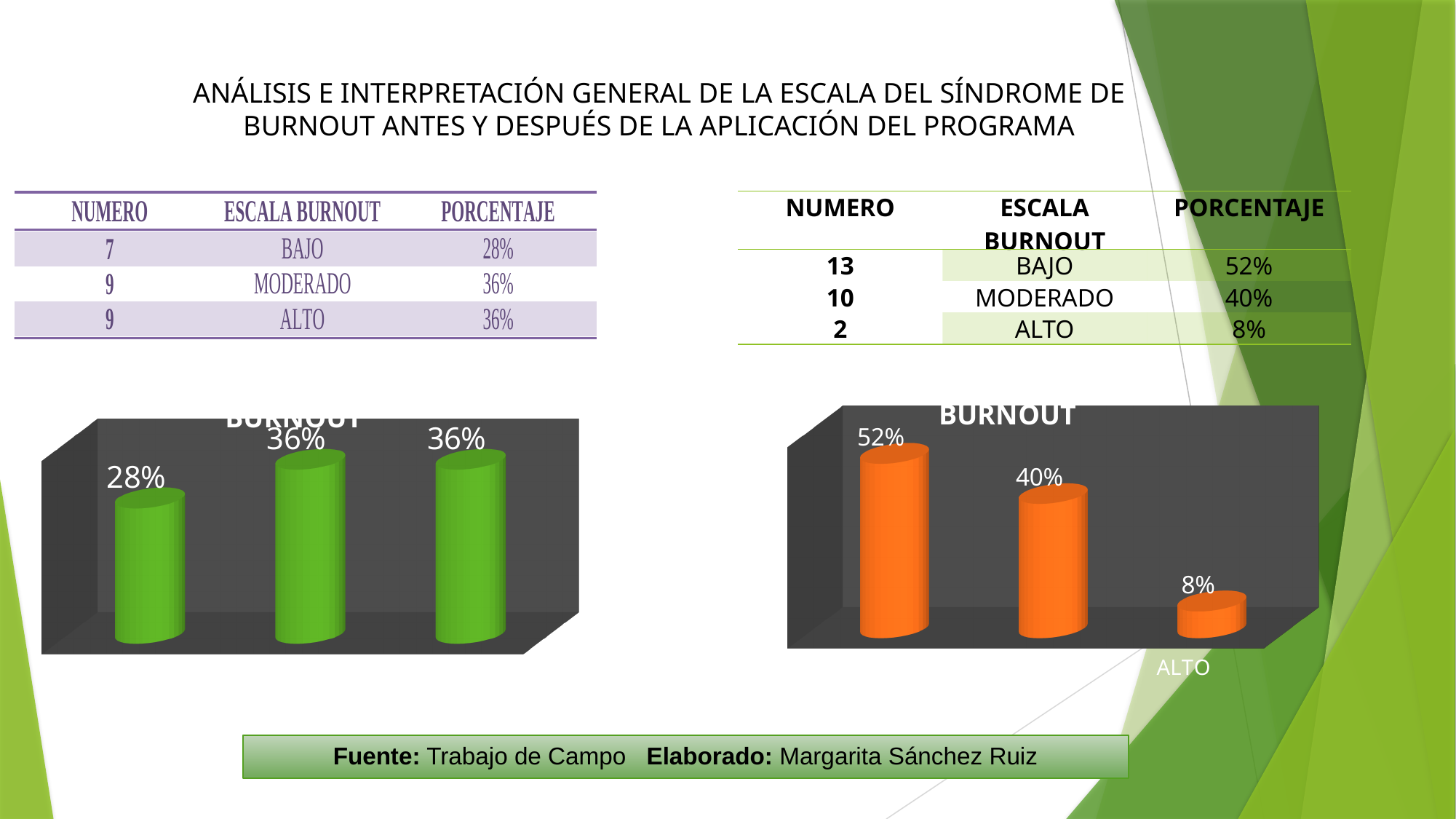
What type of chart is the left chart on the slide? bar chart In the right chart, what is the difference between the first bar (52%) and the second bar (40%)? 12% Do the values in the right chart rise or fall from left to right? fall In the left chart, what is the value of the first (leftmost) bar? 28% How many bars does the left chart show? 3 What colour are the bars in the right chart? orange In the right chart, what is the value of the first (leftmost) bar? 52% How many bars does the right chart show? 3 In the left chart, what is the difference between the second bar (36%) and the first bar (28%)? 8% In the right chart, what is the value of the bar labelled ALTO? 8% In the left chart, which bar has the lowest value? the first (leftmost) bar, 28% In the right chart, which bar has the lowest value? ALTO